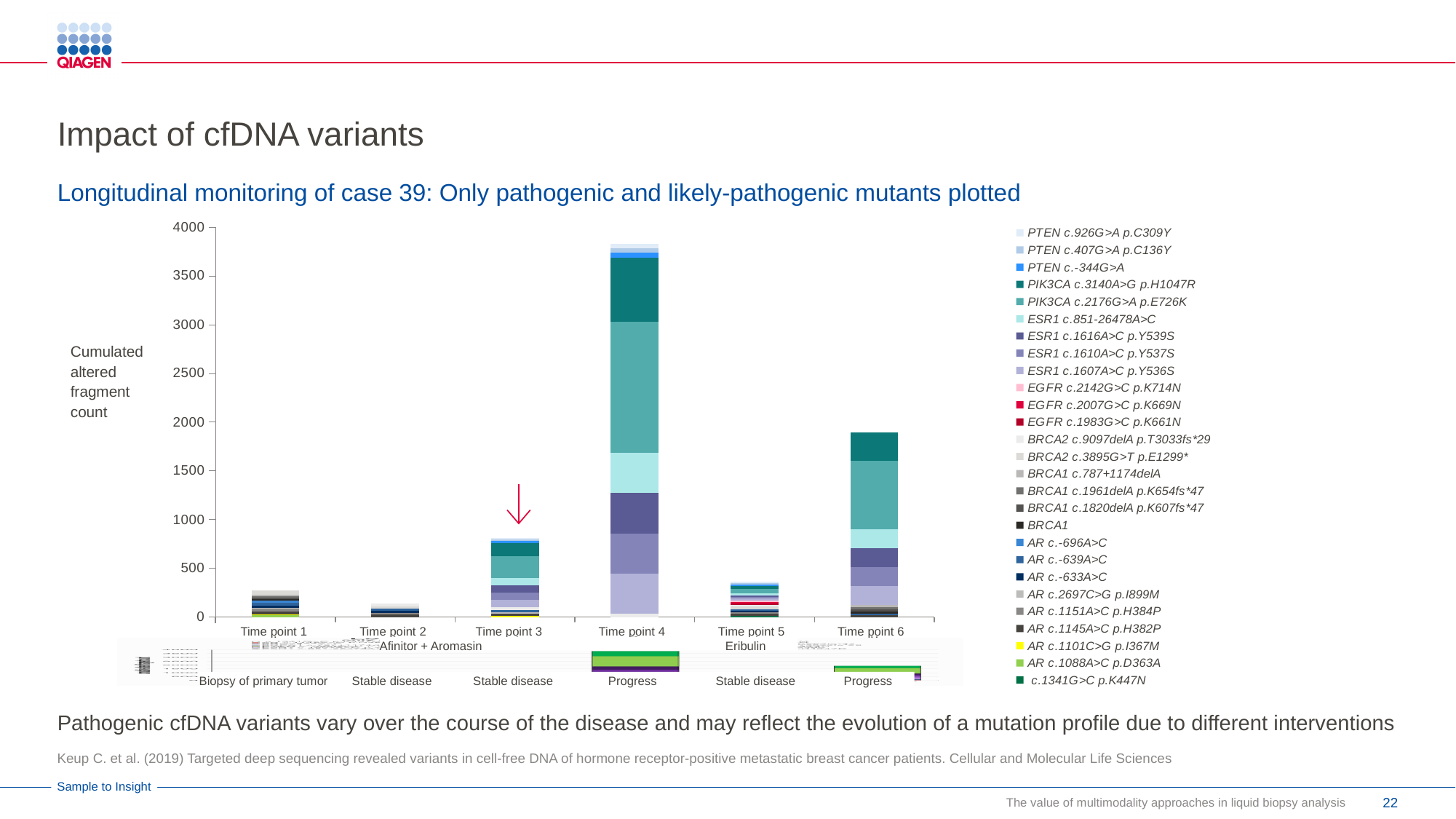
Which has the larger total, Time point 4 or Time point 6? Time point 4 What is the label of the y axis? Cumulated altered fragment count Which time point has the lowest cumulated altered fragment count? Time point 2 Is the total value for Time point 6 greater or less than 1500? greater How many variants are listed in the legend? 27 How many time points are plotted along the x axis? 6 Is the total value for Time point 3 greater or less than 1000? less Which time point has the highest cumulated altered fragment count? Time point 4 Which has the larger total, Time point 6 or Time point 3? Time point 6 Is the total value for Time point 1 greater or less than 500? less What kind of chart is shown on the slide? Stacked bar chart